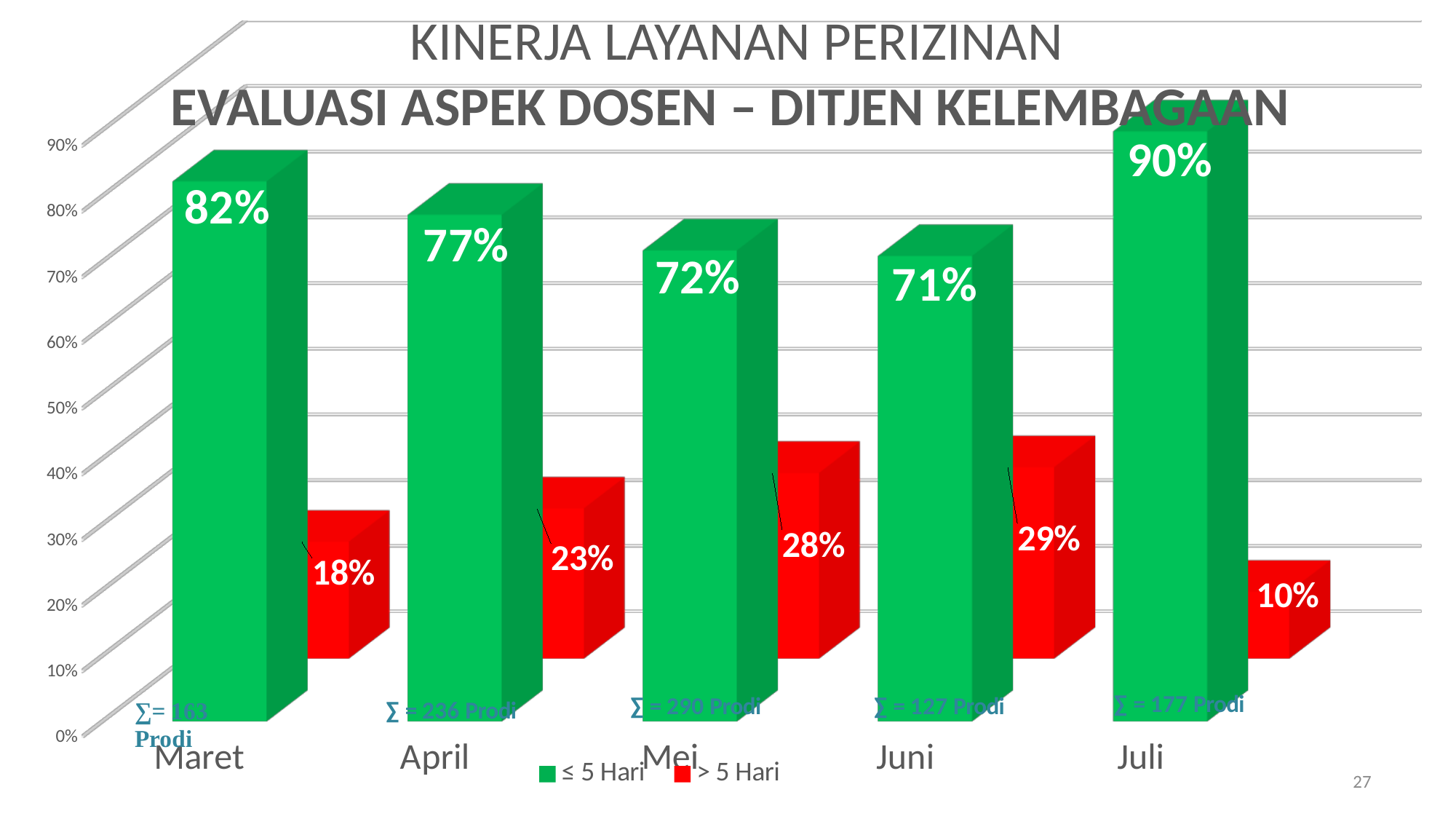
Which is larger: the "> 5 Hari" value for April or for Mei? Mei What is the value for "≤ 5 Hari" in Maret? 82% What kind of chart is shown on the slide? Bar chart What is the value for "≤ 5 Hari" in Juli? 90% How many months are shown on the x axis? 5 How many series does the legend list? 2 What is the difference between the "≤ 5 Hari" values for Maret and April? 5% Which colour represents the "> 5 Hari" series in the legend? Red Which month has the lowest value for "> 5 Hari"? Juli What is the value for "> 5 Hari" in Mei? 28% Which month has the highest value for "≤ 5 Hari"? Juli What is the value for "> 5 Hari" in Juni? 29%